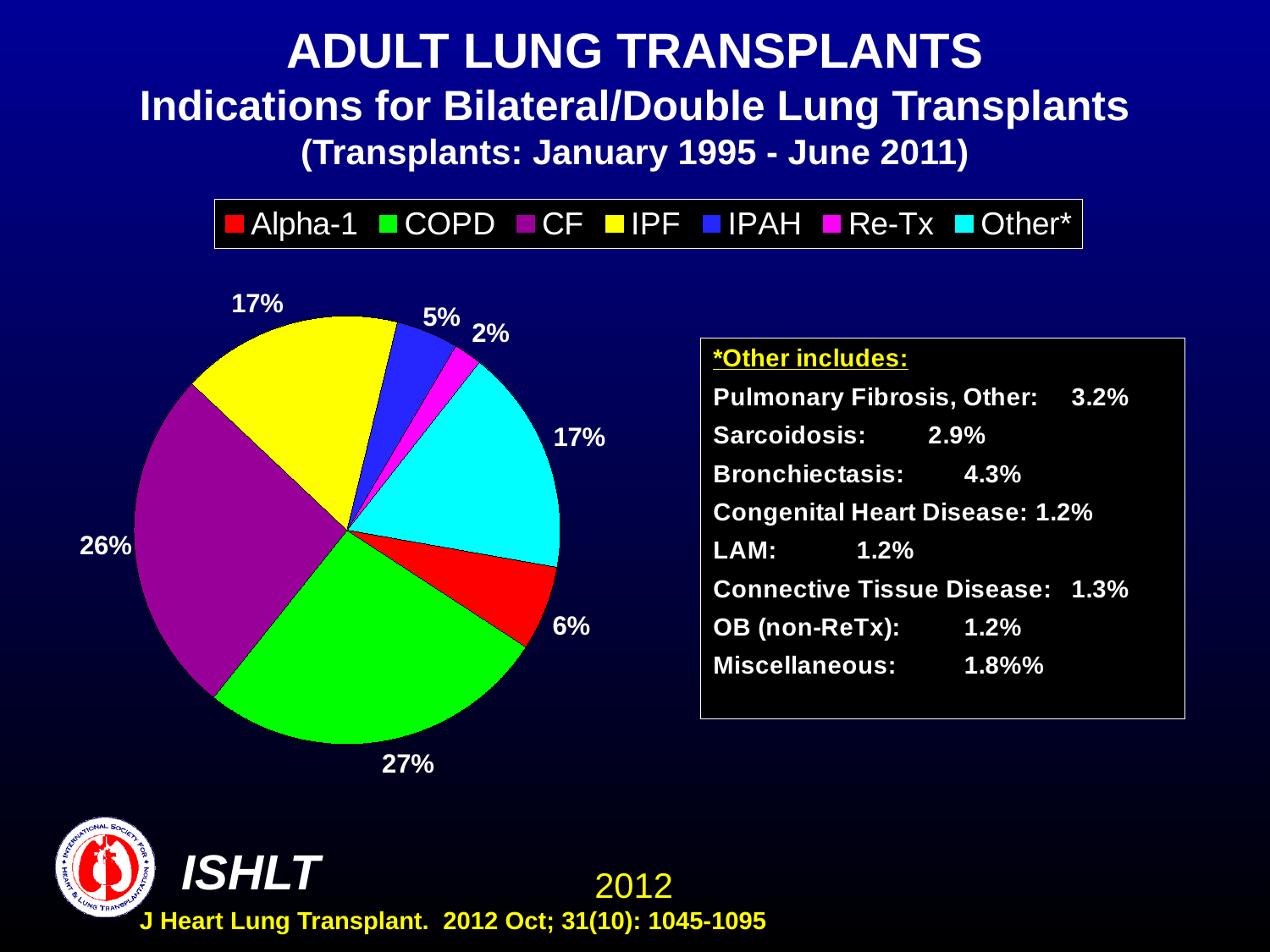
What percentage is shown for Alpha-1? 6% Which is larger, the IPAH slice or the Re-Tx slice? IPAH How many percentage points larger is the CF slice than the Alpha-1 slice? 20% What percentage is shown for Re-Tx? 2% Which indication has the largest slice of the pie? COPD How many indication categories are shown in the pie chart? 7 What percentage is shown for IPF? 17% What percentage of bilateral/double lung transplants is attributed to COPD? 27% What percentage is shown for IPAH? 5% What share of the pie does CF account for? 26% What type of chart is shown on the slide? Pie chart Which indication has the smallest slice of the pie? Re-Tx